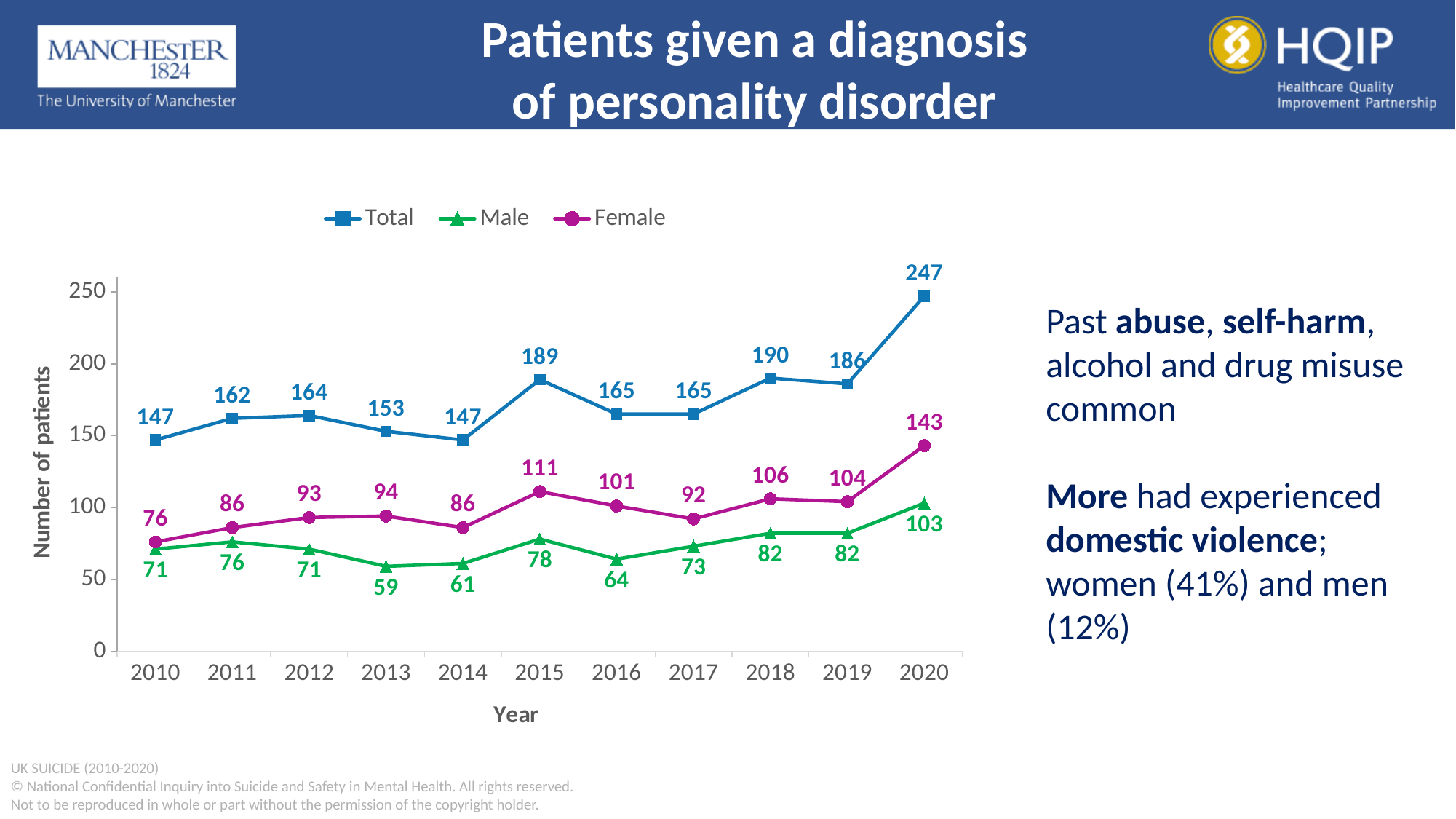
What is the difference between the Total values in 2020 and 2019? 61 What is the label of the y axis? Number of patients How many years are shown on the x axis? 11 In which year is the Total series highest? 2020 What is the Total number of patients in 2020? 247 Is the Total value for 2015 greater or less than 200? less What is the Male value in 2013? 59 Which is larger in 2017: the Female value or the Male value? Female In which year is the Male series lowest? 2013 What kind of chart is shown on the slide? Line chart How many series does the legend list? 3 What is the Female value in 2015? 111